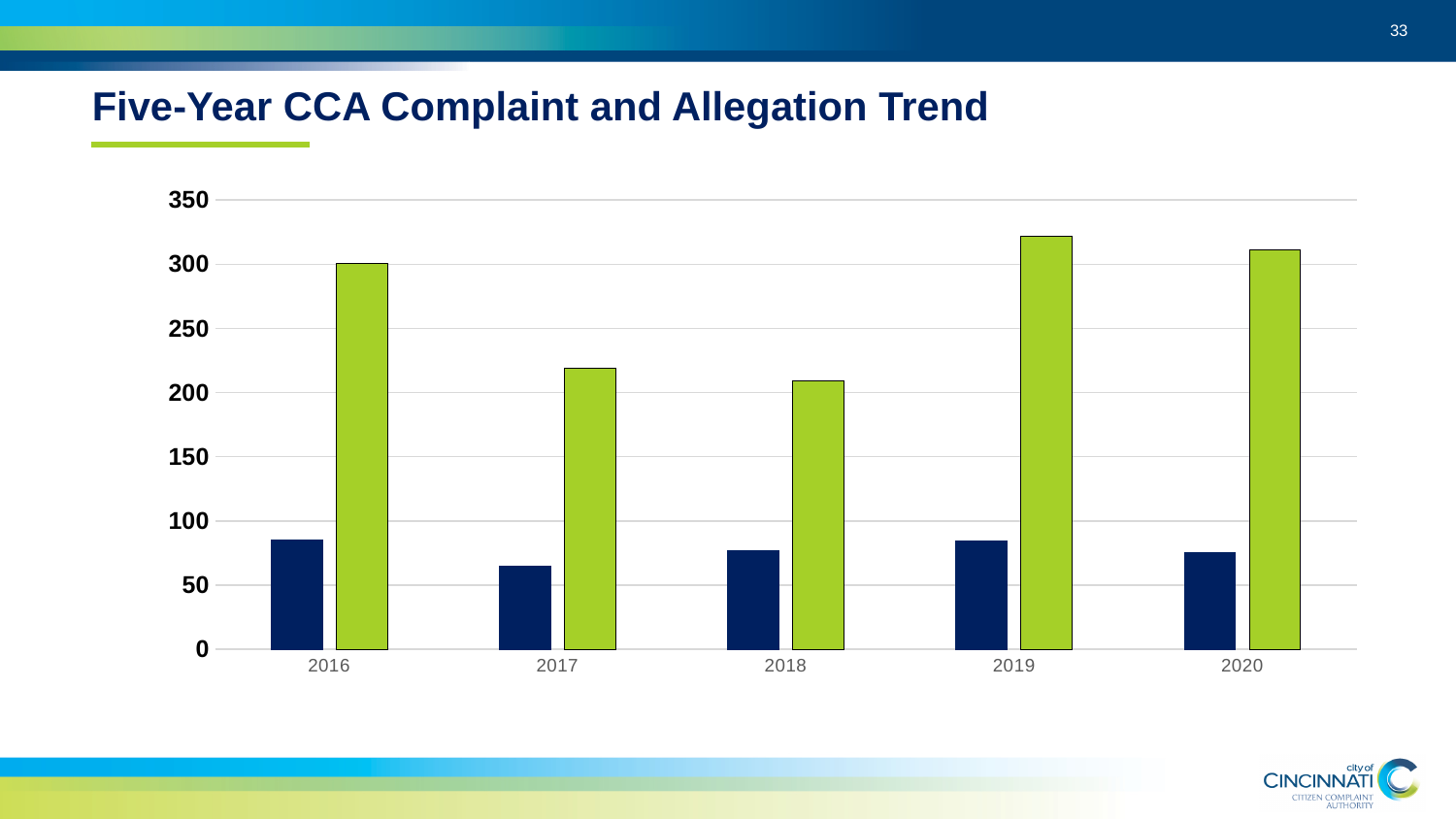
Which year has the lowest dark blue bar? 2017 Is the green bar for 2017 greater or less than 200? greater In each year, which bar is taller, the dark blue one or the green one? the green one How many years are shown on the x axis of the chart? 5 Is the dark blue bar for 2017 greater or less than 50? greater Is the dark blue bar for 2016 greater or less than 100? less What is the title of the chart? Five-Year CCA Complaint and Allegation Trend Which year has the tallest green bar? 2019 Which is larger, the green bar for 2016 or the green bar for 2017? 2016 What kind of chart is shown on the slide? bar chart